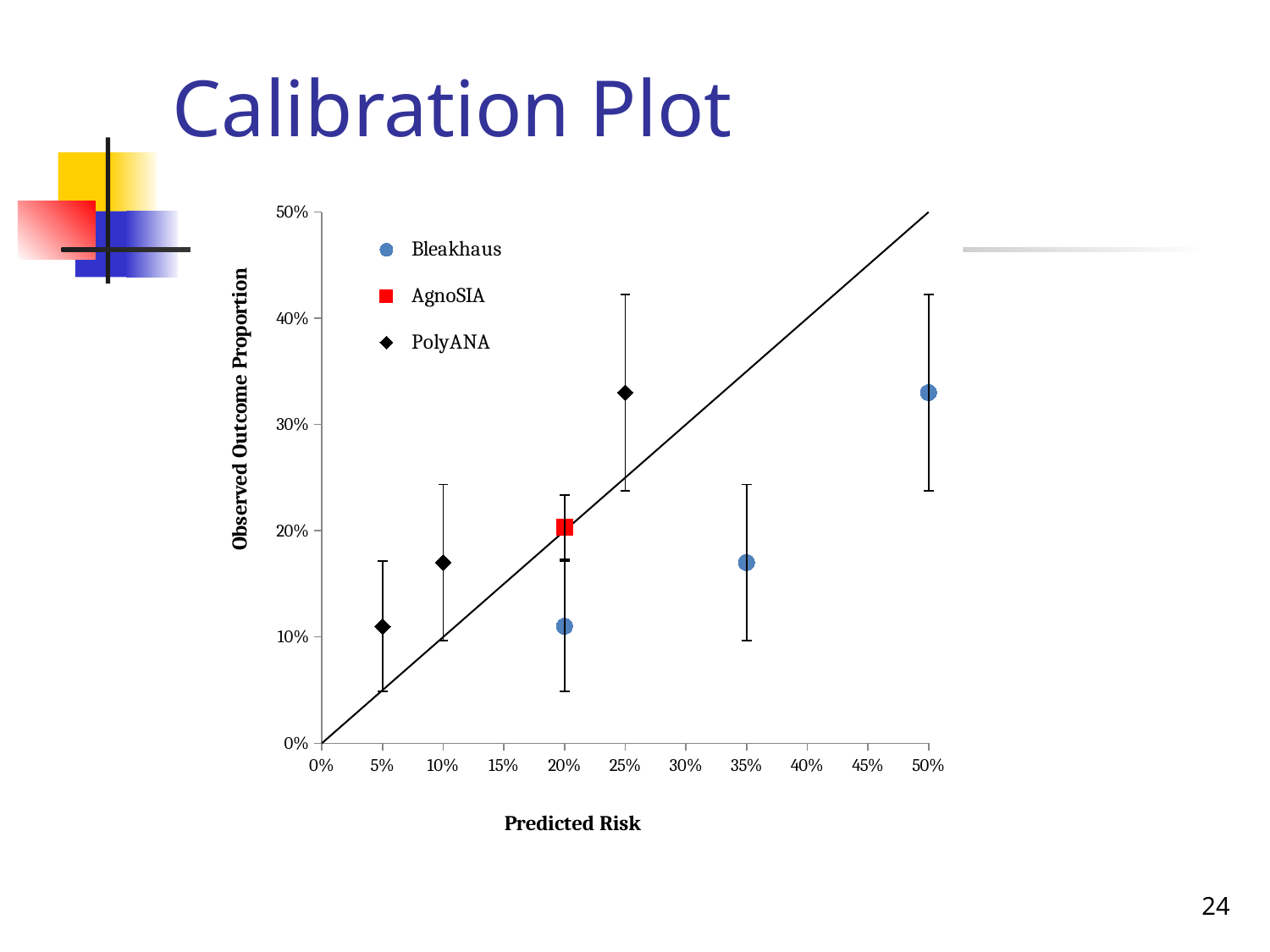
What is the title of the chart? Calibration Plot Is the observed outcome proportion for PolyANA at a predicted risk of 25% greater or less than 30%? greater At a predicted risk of 20%, which series has the higher observed outcome proportion, AgnoSIA or Bleakhaus? AgnoSIA How many data points are plotted for the AgnoSIA series? 1 How many series does the legend list? 3 Is the observed outcome proportion for Bleakhaus at a predicted risk of 20% greater or less than 20%? less Is the observed outcome proportion for Bleakhaus at a predicted risk of 50% greater or less than 30%? greater How many data points are plotted for the PolyANA series? 3 What kind of chart is shown on the slide? Scatter plot How many data points are plotted for the Bleakhaus series? 3 What is the label of the x axis? Predicted Risk